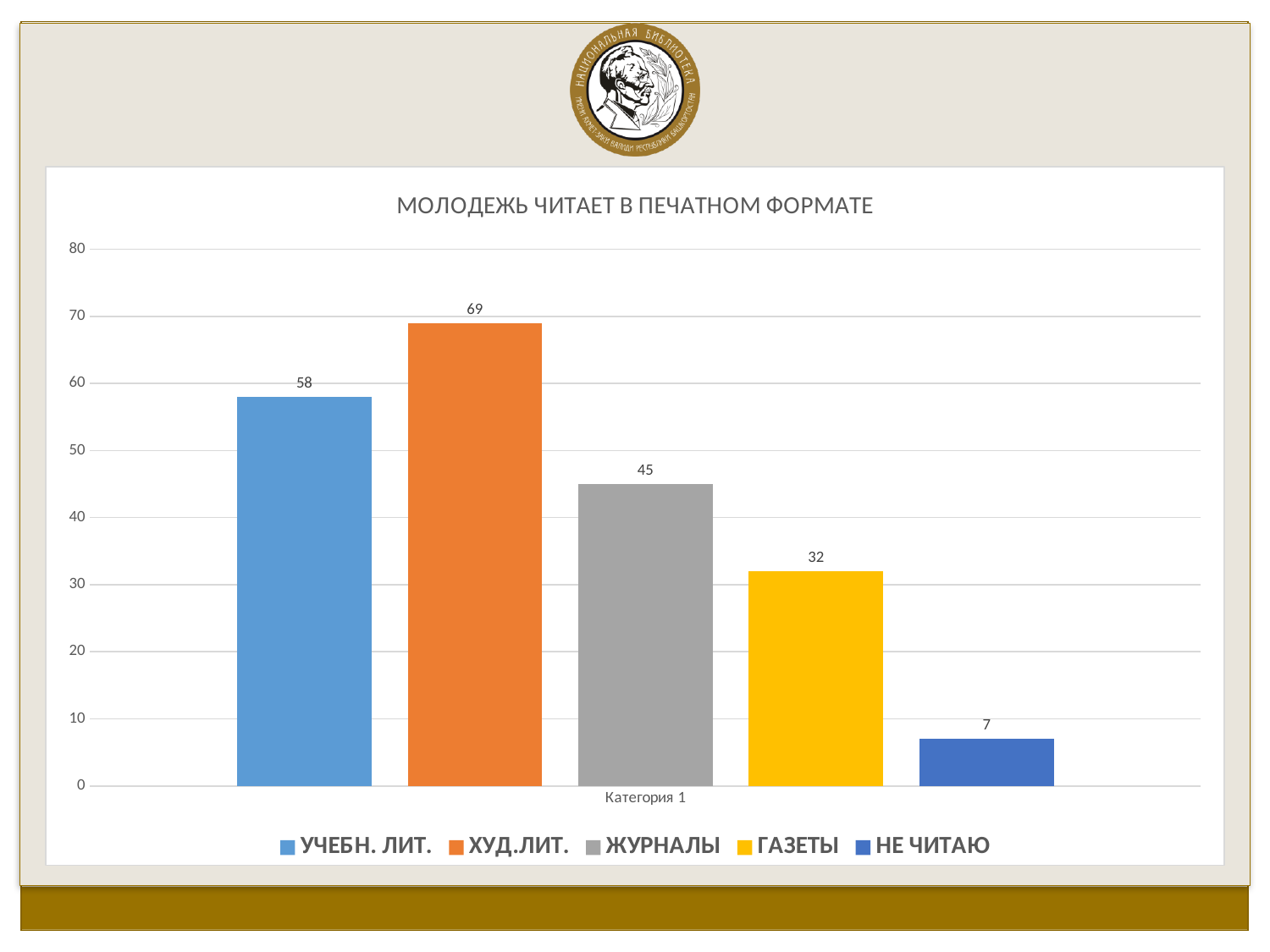
What is the value for ЖУРНАЛЫ? 45 What kind of chart is shown on the slide? bar chart What is the value for ХУД.ЛИТ.? 69 Which series has the highest value? ХУД.ЛИТ. What is the value for НЕ ЧИТАЮ? 7 Which is larger, the value for УЧЕБН. ЛИТ. or the value for ГАЗЕТЫ? УЧЕБН. ЛИТ. What is the difference between the values for ЖУРНАЛЫ and ГАЗЕТЫ? 13 Which series has the lowest value? НЕ ЧИТАЮ How many series does the legend list? 5 Is the value for ГАЗЕТЫ greater or less than 40? less What is the difference between the values for ХУД.ЛИТ. and УЧЕБН. ЛИТ.? 11 What is the title of the chart? МОЛОДЕЖЬ ЧИТАЕТ В ПЕЧАТНОМ ФОРМАТЕ